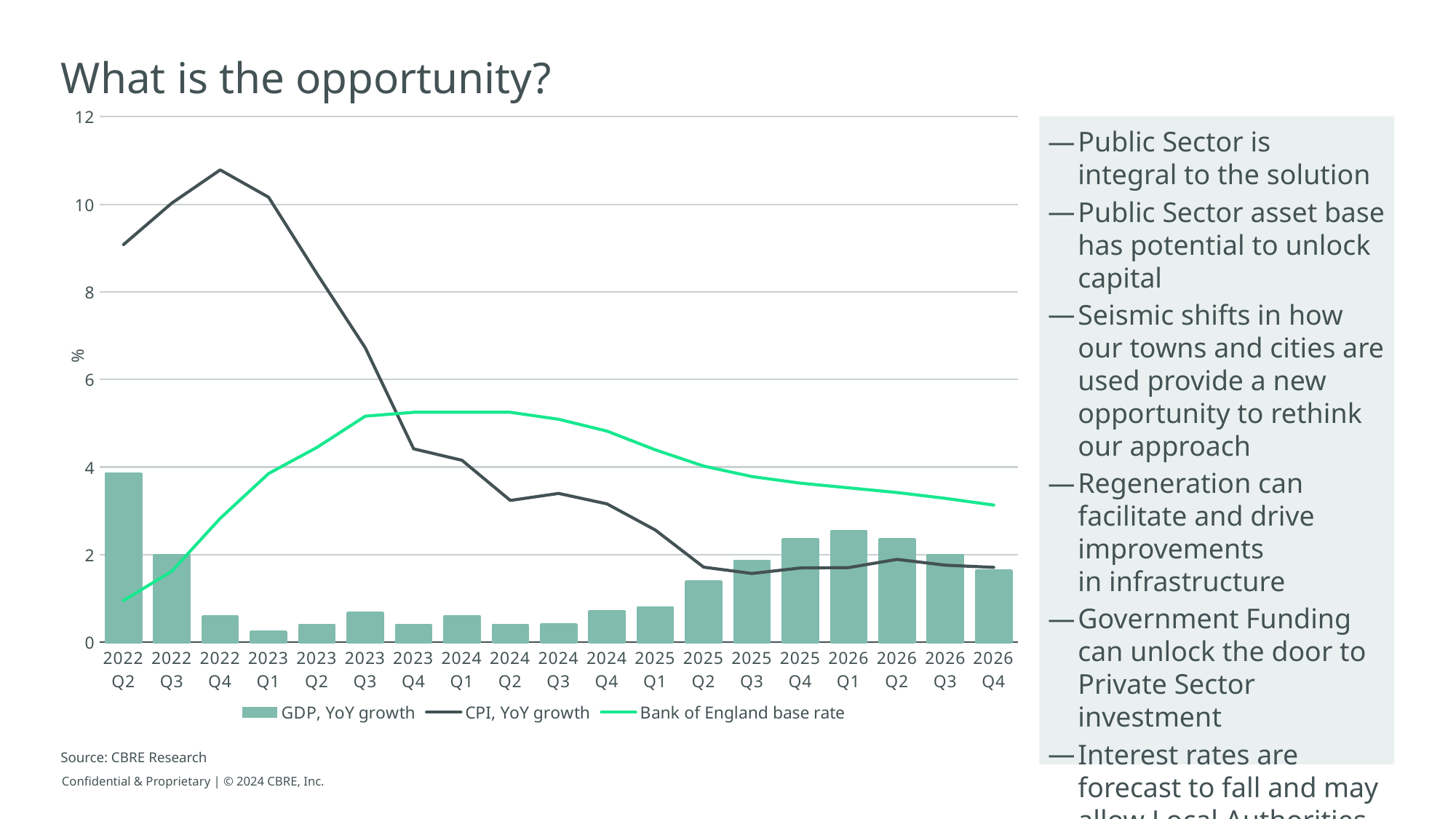
Is the GDP, YoY growth value for 2022 Q2 greater or less than 4? less How many quarters are shown on the x axis? 19 Is the Bank of England base rate for 2026 Q4 greater or less than 2? greater In which quarter is GDP, YoY growth highest? 2022 Q2 Does CPI, YoY growth rise or fall between 2022 Q4 and 2025 Q2? Fall In which quarter does CPI, YoY growth reach its peak? 2022 Q4 In which quarter is GDP, YoY growth lowest? 2023 Q1 What kind of chart is shown on the slide? Combined bar and line chart How many series does the legend list? 3 Which is larger in 2026 Q4, CPI, YoY growth or the Bank of England base rate? Bank of England base rate Is the CPI, YoY growth value for 2022 Q4 greater or less than 10? greater What is the label on the vertical axis? %